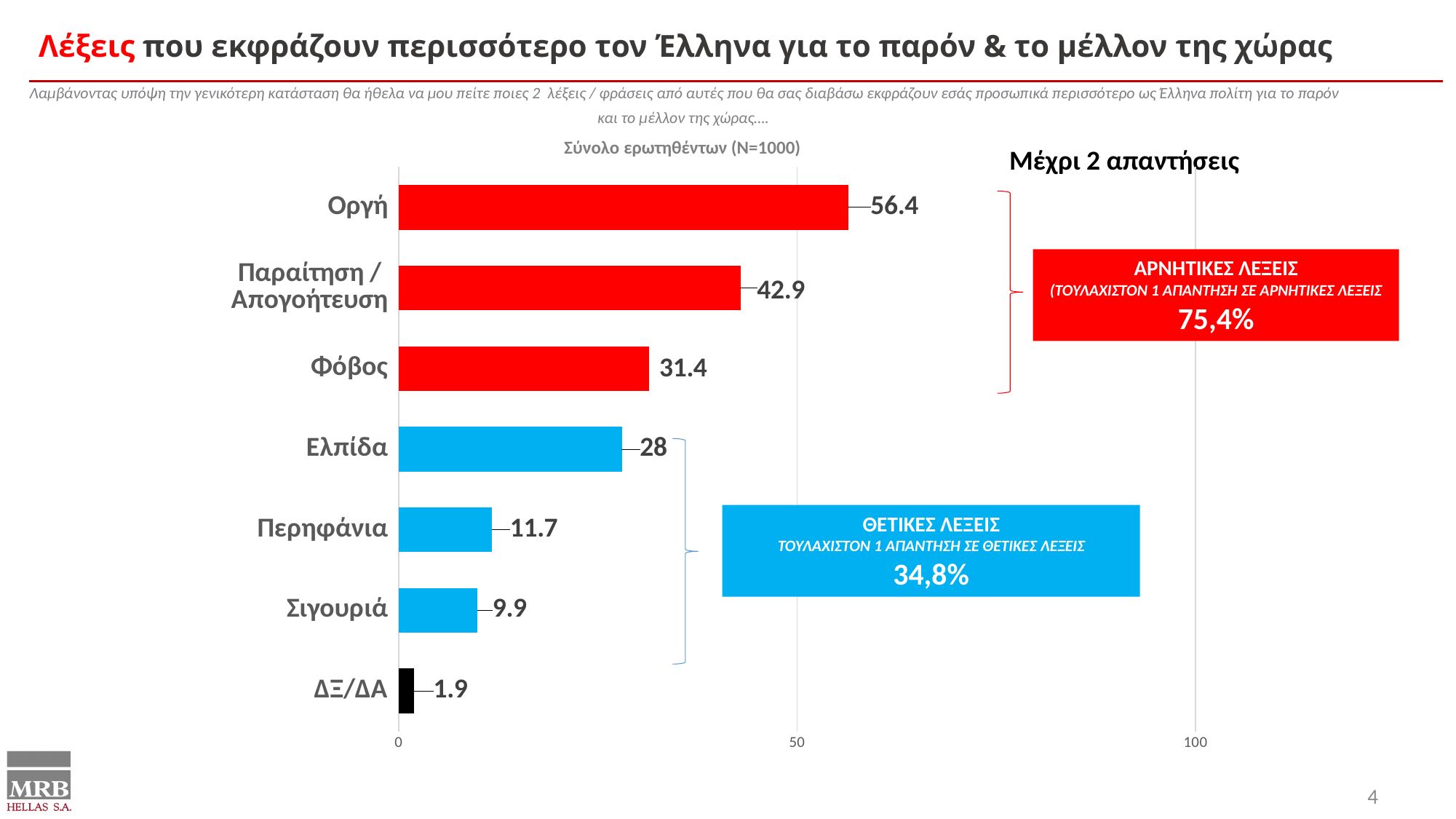
Which category has the highest value? Οργή Which is larger, the value for Περηφάνια or the value for Σιγουριά? Περηφάνια What percentage is shown in the red box labelled ΑΡΝΗΤΙΚΕΣ ΛΕΞΕΙΣ? 75,4% What is the value for Οργή? 56.4 What is the difference between the values for Οργή and Φόβος? 25 Is the value for Φόβος greater or less than 50? less What is the value for Ελπίδα? 28 How many categories are shown in the chart? 7 What is the value for Παραίτηση / Απογοήτευση? 42.9 What kind of chart is shown on the slide? bar chart What is the value for Σιγουριά? 9.9 Which category has the lowest value? ΔΞ/ΔΑ